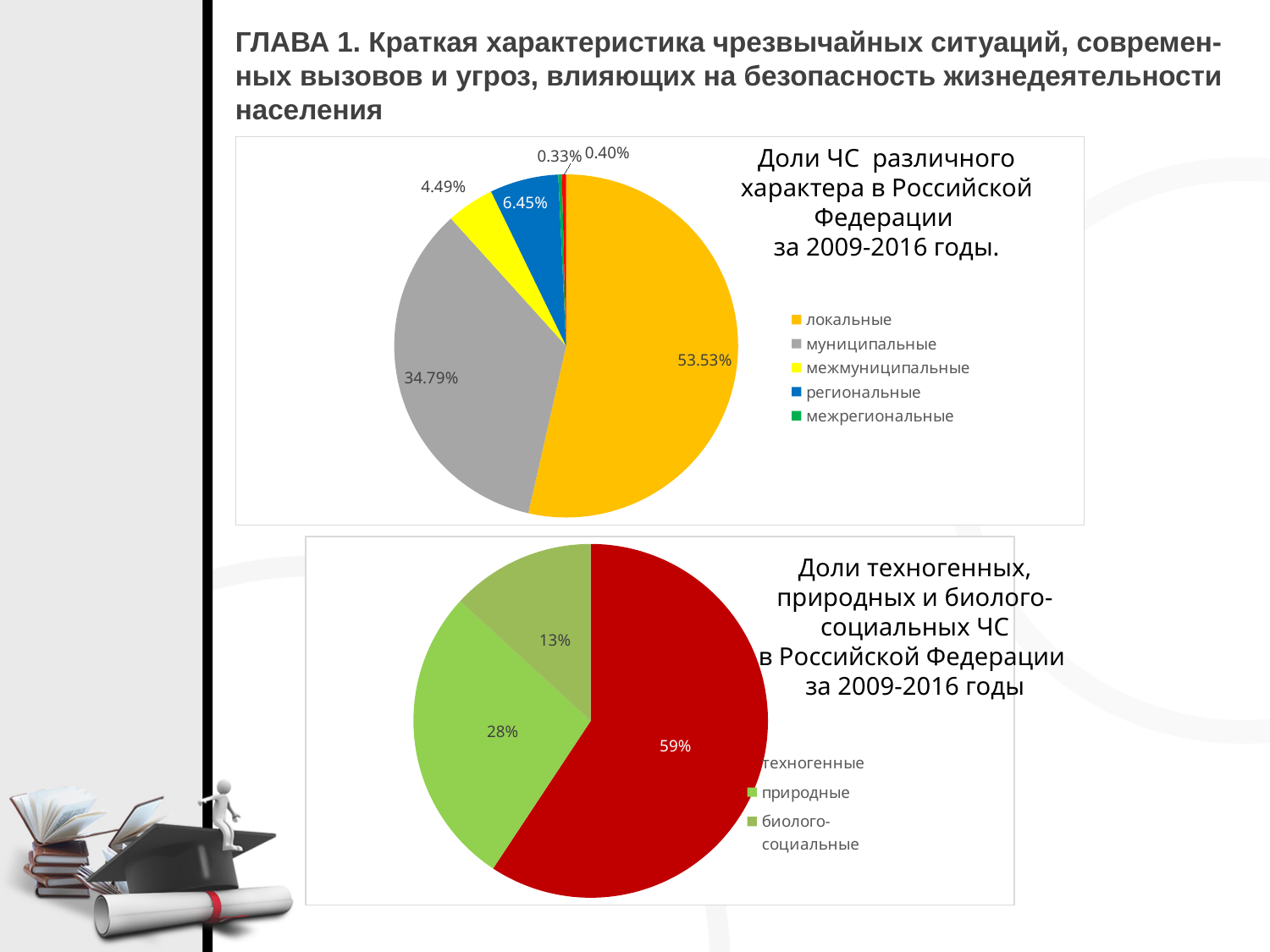
In the top chart (Доли ЧС различного характера), what is the difference between the shares of локальные and муниципальные? 18.74% In the top chart (Доли ЧС различного характера), what share is shown for локальные? 53.53% In the bottom chart (Доли техногенных, природных и биолого-социальных ЧС), what is the difference between the shares of техногенные and природные? 31% In the top chart (Доли ЧС различного характера), what share is shown for межмуниципальные? 4.49% In the top chart (Доли ЧС различного характера), which category has the largest share? локальные In the bottom chart (Доли техногенных, природных и биолого-социальных ЧС), what share is shown for природные? 28% In the bottom chart (Доли техногенных, природных и биолого-социальных ЧС), which category has the smallest share? биолого-социальные In the top chart (Доли ЧС различного характера), what share is shown for муниципальные? 34.79% In the top chart (Доли ЧС различного характера), how many entries does the legend list? 5 In the top chart (Доли ЧС различного характера), what share is shown for региональные? 6.45% In the top chart (Доли ЧС различного характера), which is larger: региональные or межмуниципальные? региональные What type of chart is the bottom chart (Доли техногенных, природных и биолого-социальных ЧС)? pie chart